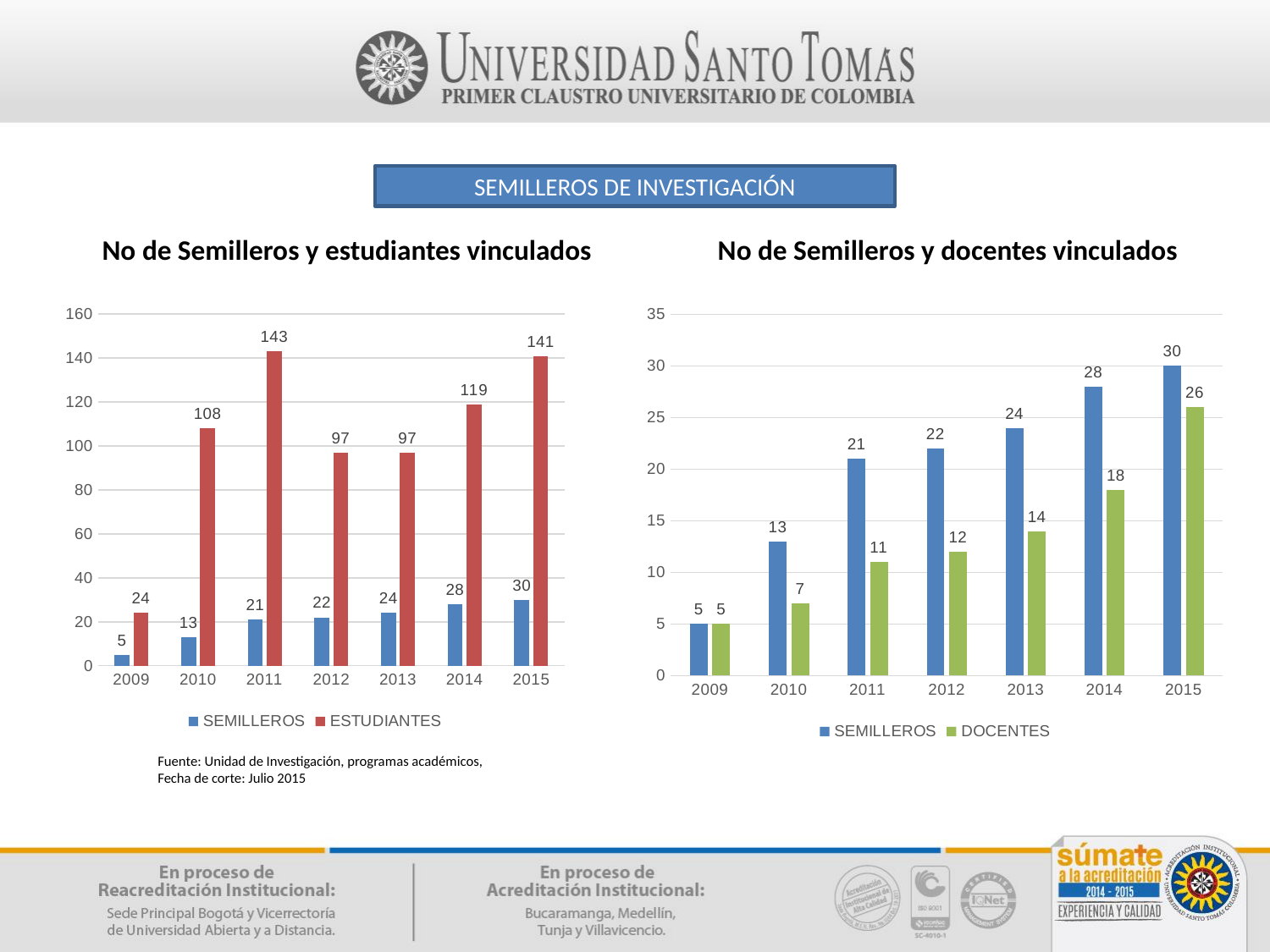
In the chart 'No de Semilleros y estudiantes vinculados', what kind of chart is shown? Bar chart In the chart 'No de Semilleros y estudiantes vinculados', what is the difference between ESTUDIANTES in 2015 and ESTUDIANTES in 2014? 22 In the chart 'No de Semilleros y docentes vinculados', do the SEMILLEROS values rise or fall from 2009 to 2015? Rise In the chart 'No de Semilleros y estudiantes vinculados', which is larger: ESTUDIANTES in 2010 or ESTUDIANTES in 2012? ESTUDIANTES in 2010 In the chart 'No de Semilleros y docentes vinculados', what is the difference between SEMILLEROS and DOCENTES in 2014? 10 In the chart 'No de Semilleros y estudiantes vinculados', how many series does the legend list? 2 In the chart 'No de Semilleros y estudiantes vinculados', which year has the lowest value for SEMILLEROS? 2009 In the chart 'No de Semilleros y docentes vinculados', what is the value for DOCENTES in 2013? 14 In the chart 'No de Semilleros y estudiantes vinculados', what is the value for ESTUDIANTES in 2011? 143 In the chart 'No de Semilleros y docentes vinculados', what colour are the DOCENTES bars? Green In the chart 'No de Semilleros y docentes vinculados', which year has the highest value for DOCENTES? 2015 In the chart 'No de Semilleros y docentes vinculados', how many years are shown on the x axis? 7